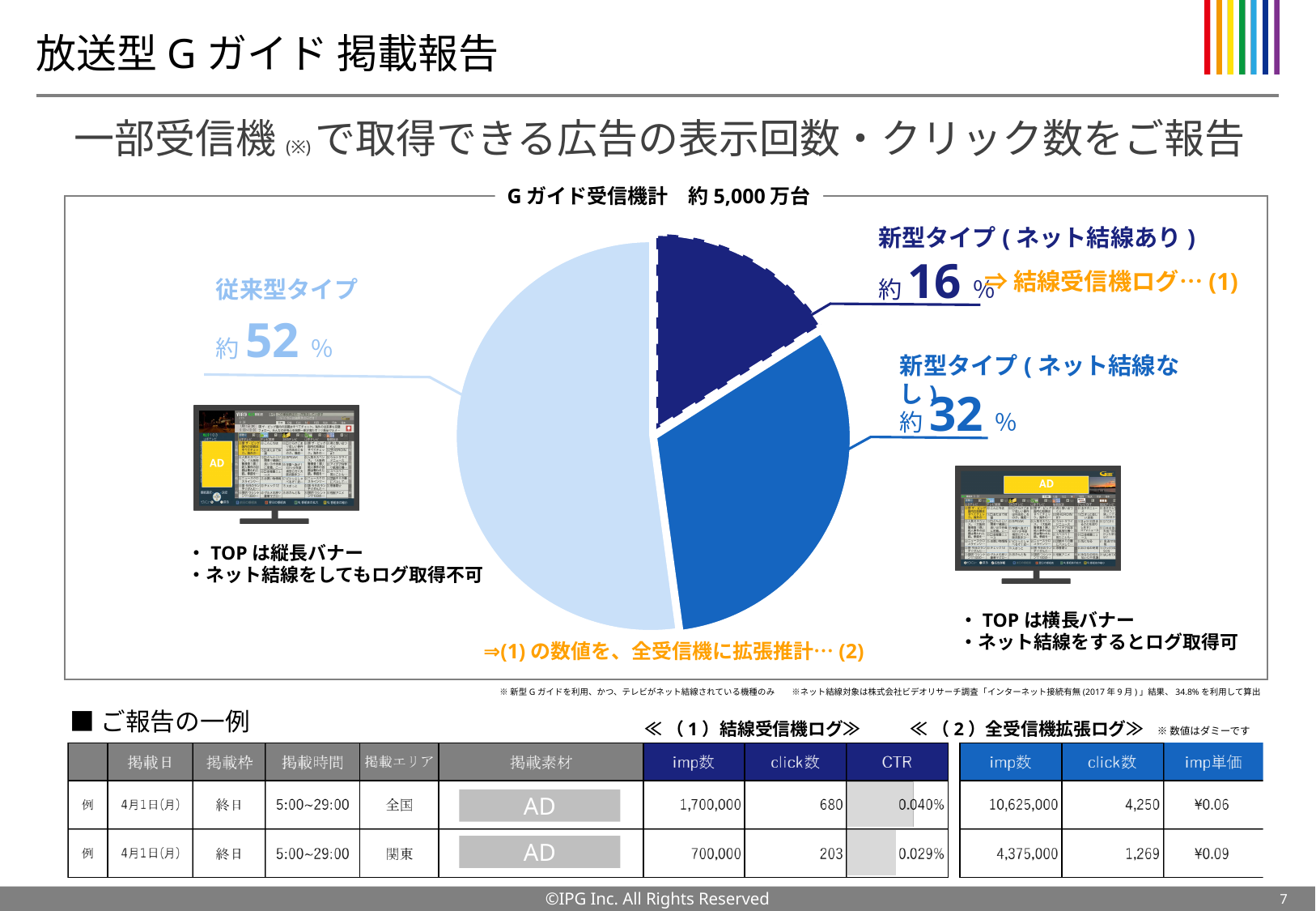
Which slice of the pie chart is the largest? 従来型タイプ Which is larger in the pie chart: the share for 新型タイプ(ネット結線なし) or the share for 新型タイプ(ネット結線あり)? 新型タイプ(ネット結線なし) What share of the pie chart is labelled for 新型タイプ(ネット結線あり)? 約16% Which slice of the pie chart is drawn in the darkest navy colour? 新型タイプ(ネット結線あり) What share of the pie chart is labelled for 従来型タイプ? 約52% What kind of chart is shown on the slide? Pie chart What is the title shown above the pie chart? Gガイド受信機計 約5,000万台 By how many percentage points does the 従来型タイプ share exceed the 新型タイプ(ネット結線あり) share in the pie chart? 36 percentage points By how many percentage points does the 新型タイプ(ネット結線なし) share exceed the 新型タイプ(ネット結線あり) share? 16 percentage points Which slice of the pie chart is the smallest? 新型タイプ(ネット結線あり) How many slices does the pie chart have? 3 What share of the pie chart is labelled for 新型タイプ(ネット結線なし)? 約32%